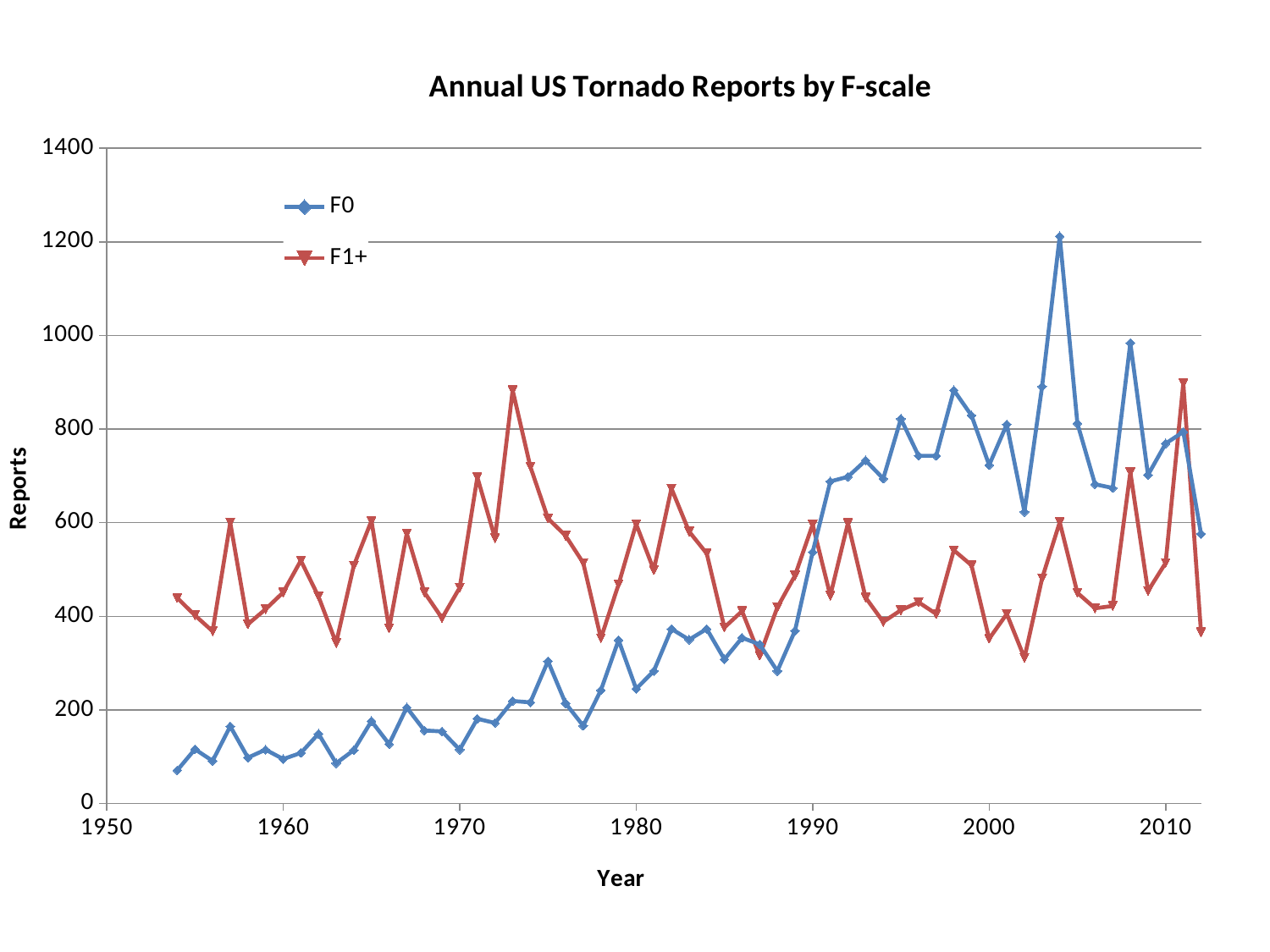
What is the title of the chart? Annual US Tornado Reports by F-scale In which year does the F0 series reach its highest value? 2004 What are the two series named in the legend? F0 and F1+ How many series does the legend list? 2 In 1960, which series has the larger value, F0 or F1+? F1+ Is the F1+ value for 2012 greater or less than 400? less Overall, does the F0 series rise or fall from 1954 to 2012? rise What kind of chart is shown on the slide? line chart Is the F1+ value for 1973 greater or less than 800? greater Is the F0 value for 1954 greater or less than 100? less In 2000, which series has the larger value, F0 or F1+? F0